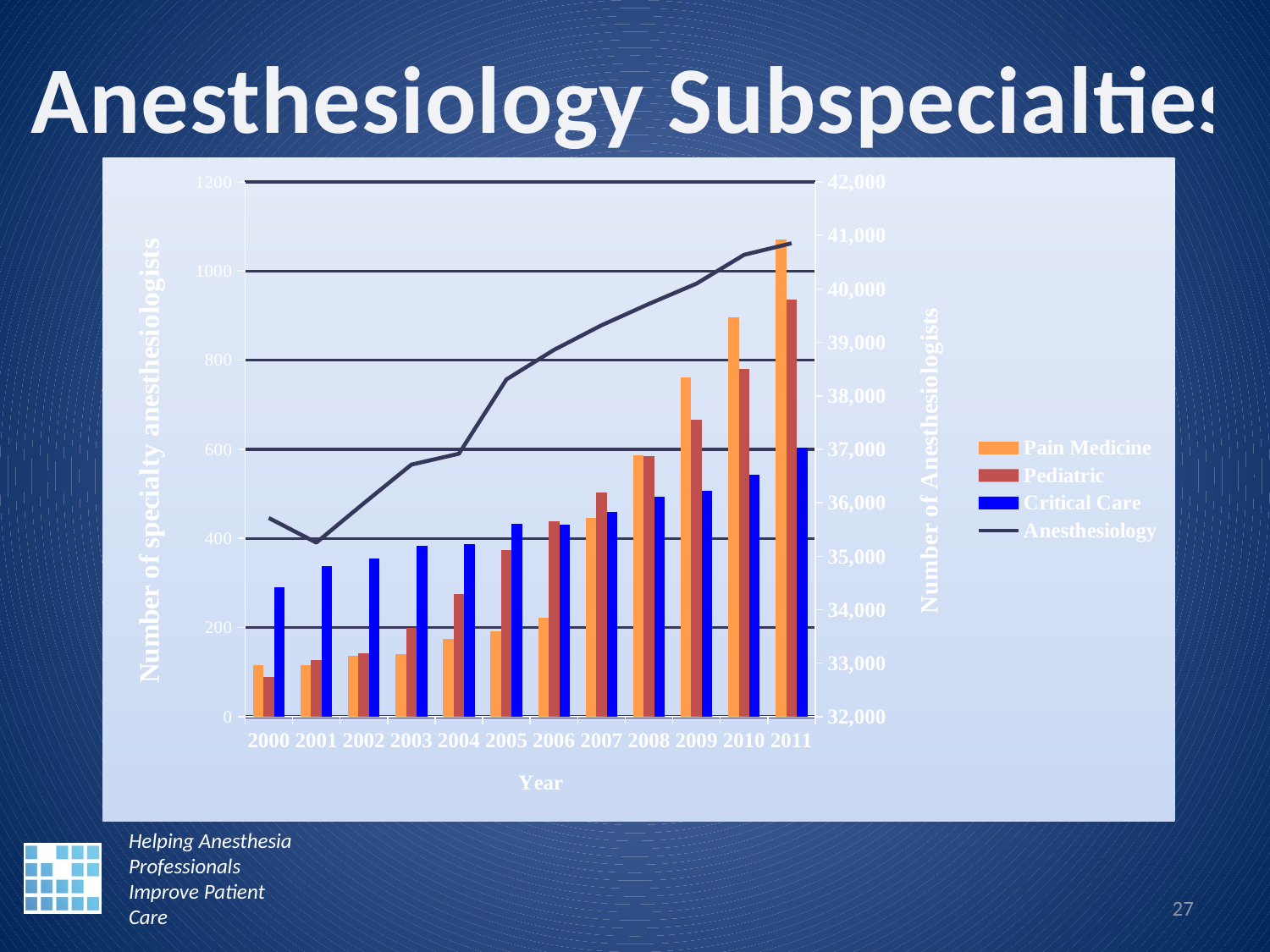
What is the title of the left vertical axis? Number of specialty anesthesiologists Is the Anesthesiology value in 2011 greater or less than 40,000? greater What kind of chart is shown on the slide? bar chart with a line In 2011, which is larger: Pain Medicine or Pediatric? Pain Medicine How many years are shown on the x axis? 12 Do the Pediatric values rise or fall from 2000 to 2011? rise How many series does the legend list? 4 Is the value for Pain Medicine in 2011 greater or less than 1000? greater In which year is the Anesthesiology line at its lowest point? 2001 In which year is the Pain Medicine bar highest? 2011 Is the value for Critical Care in 2000 greater or less than 200? greater In 2000, which is larger: Critical Care or Pain Medicine? Critical Care